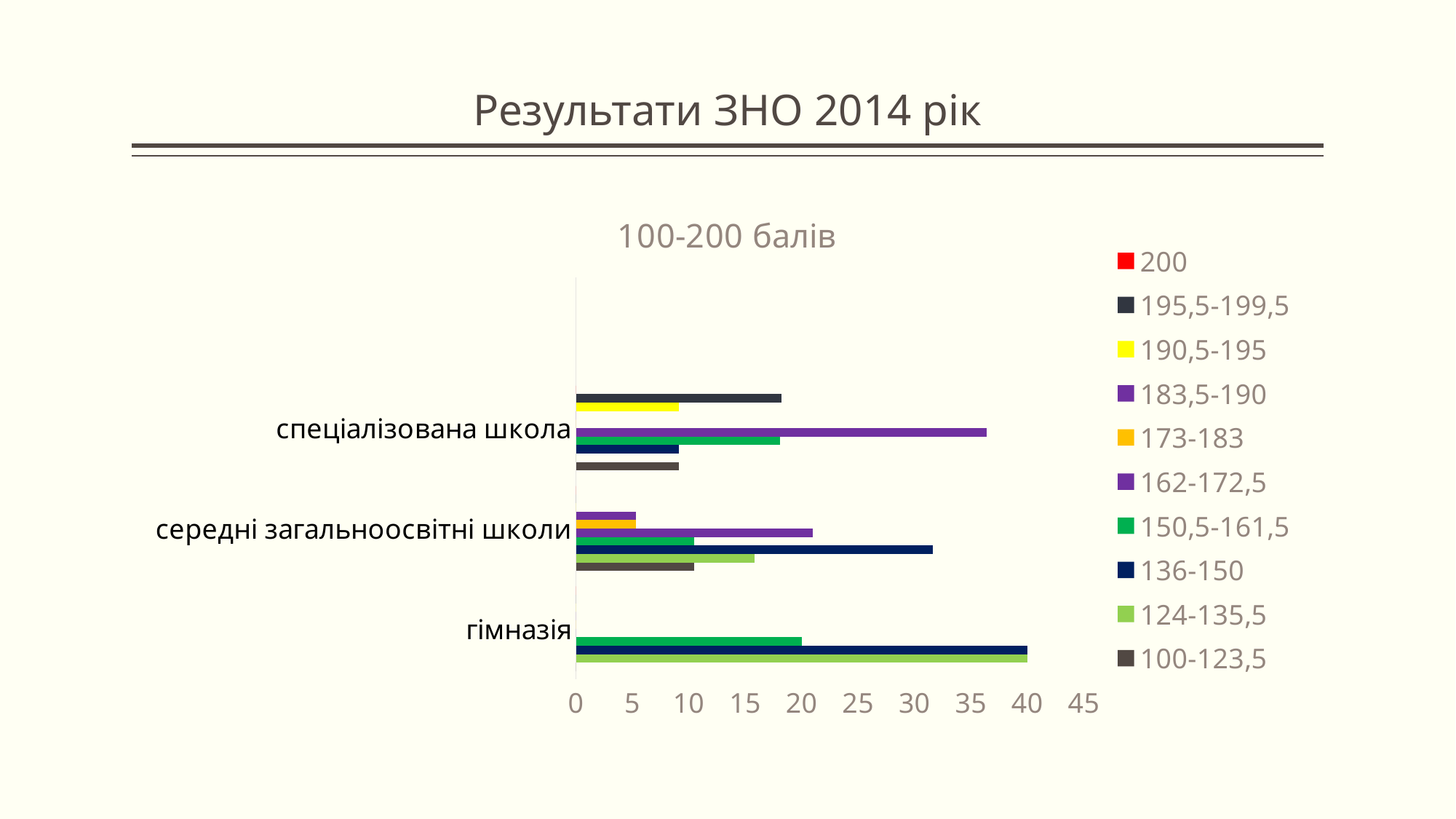
What kind of chart is shown on the slide? bar chart Is the value of the 150,5-161,5 series for спеціалізована школа greater or less than 15? greater Is the value of the 190,5-195 series for спеціалізована школа greater or less than 15? less How many school categories are shown on the y axis of the chart? 3 For гімназія, which series has the larger value: 136-150 or 150,5-161,5? 136-150 Which school category has the highest value for the 136-150 series? гімназія What is the title of the chart? 100-200 балів Is the value of the 136-150 series for гімназія greater or less than 35? greater What colour is the legend marker for the series "200"? red How many series does the chart legend list? 10